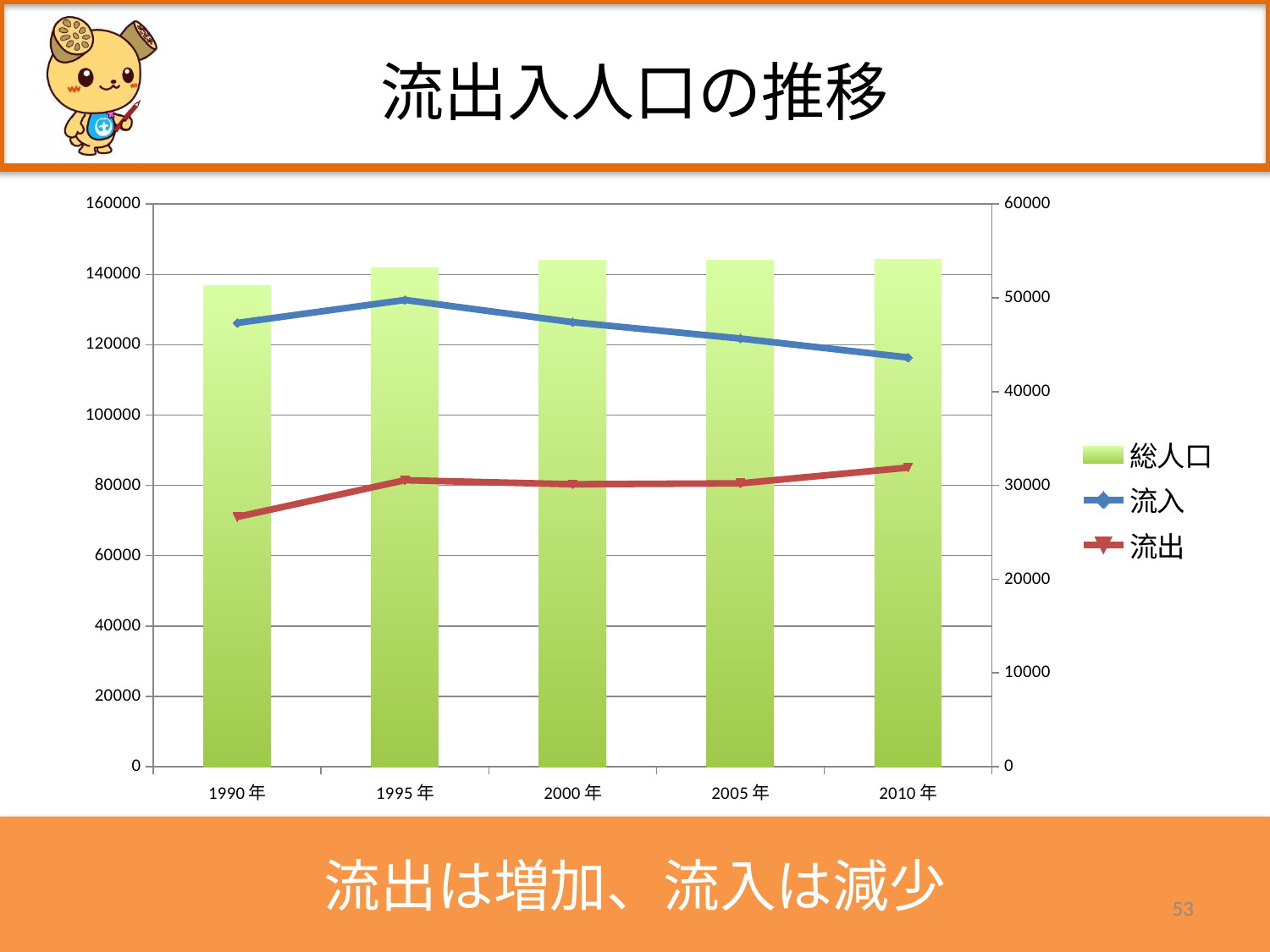
In which year is 流入 (inflow) highest? 1995年 In which year is 流入 (inflow) lowest? 2010年 Is the value for 流入 in 2010年 greater or less than 40000? greater Is the value for 総人口 in 1990年 greater or less than 140000? less What kind of chart is shown on the slide? A combined bar and line chart How many years are shown on the x axis? 5 In which year is 流出 (outflow) lowest? 1990年 In which year is 総人口 (total population) lowest? 1990年 Does the 流入 (inflow) line rise or fall from 1995年 to 2010年? fall How many series does the legend list? 3 What is the title of the chart slide? 流出入人口の推移 In which year is 流出 (outflow) highest? 2010年